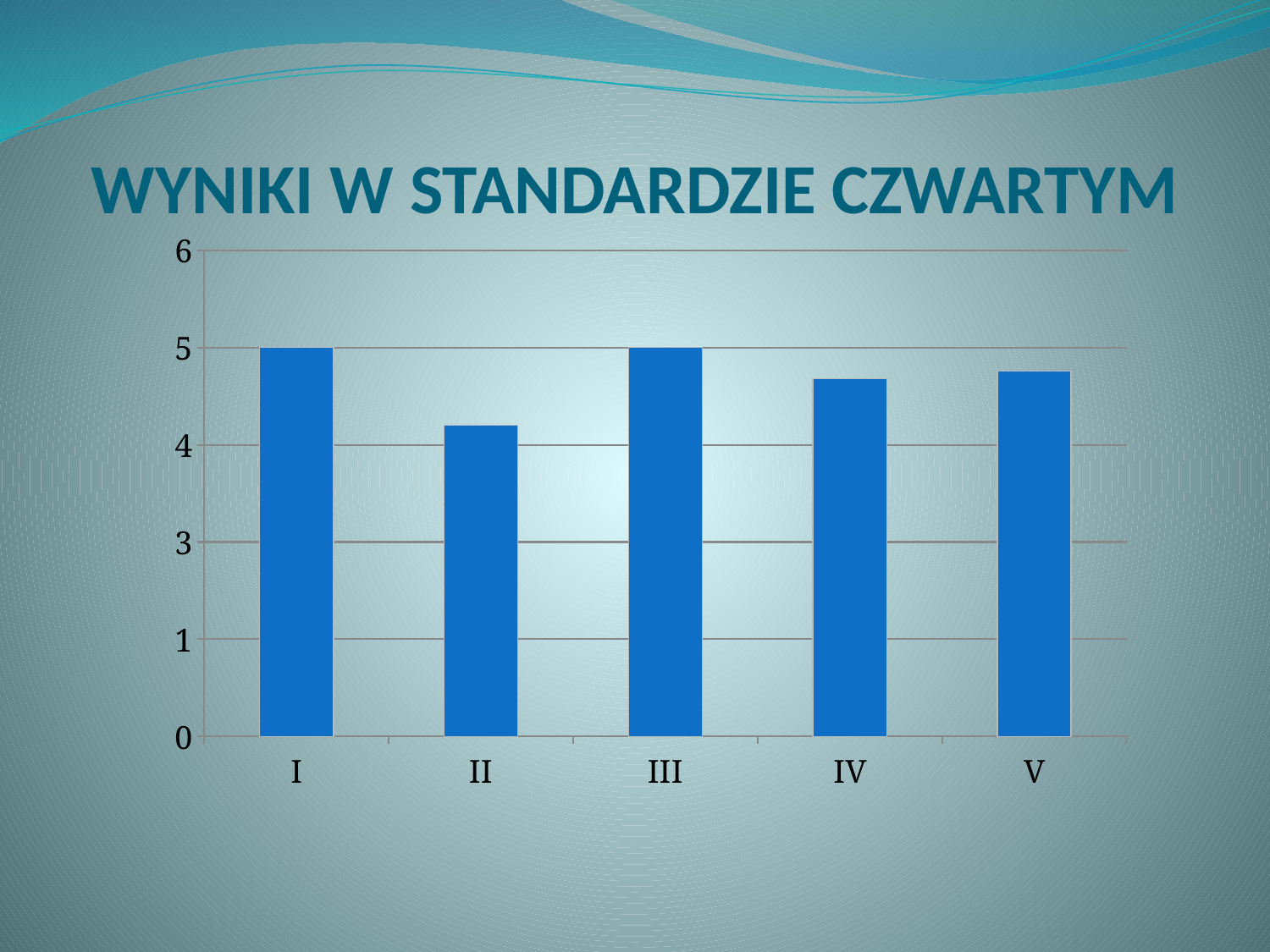
How many categories are shown on the x axis of the chart? 5 Which category has the lowest value? II Which has the larger value, category II or category IV? IV What type of chart is shown on the slide? bar chart Is the value for category II greater or less than 5? less What is the value for category I? 5 Is the value for category II greater or less than 4? greater Is the value for category IV greater or less than 5? less Which has the larger value, category II or category V? V What is the value for category III? 5 What is the title of the chart? WYNIKI W STANDARDZIE CZWARTYM